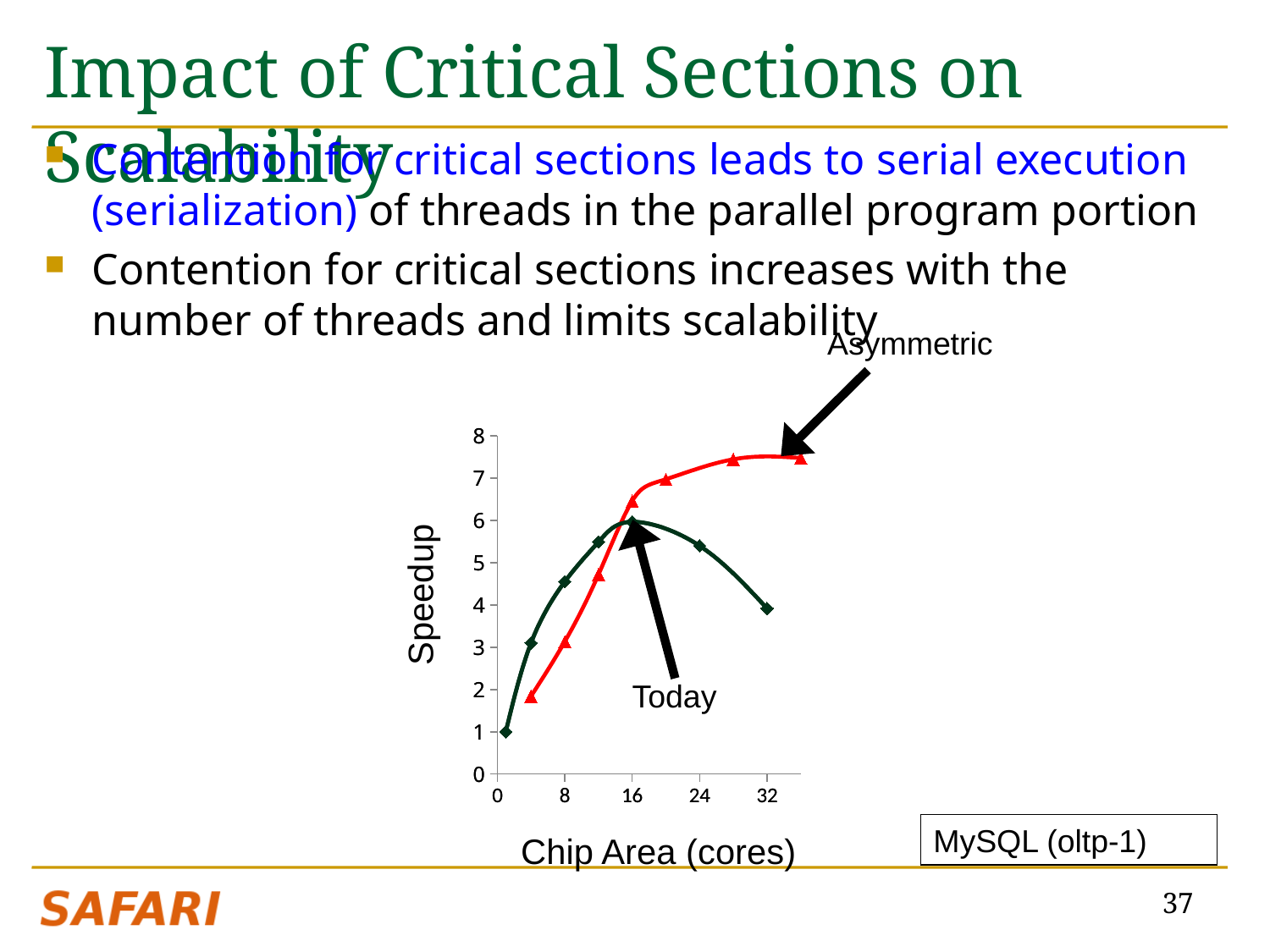
At 24 cores, which curve has the higher speedup, Today (green) or Asymmetric (red)? Asymmetric (red) Is the speedup of the Asymmetric (red) curve at 32 cores greater or less than 7? greater At 8 cores, which curve has the higher speedup, Today (green) or Asymmetric (red)? Today (green) Is the speedup of the Today (green) curve at 8 cores greater or less than 4? greater How does the speedup of the Today (green) curve change as chip area increases beyond 16 cores? it falls What kind of chart is shown on the slide? line chart Is the speedup of the Asymmetric (red) curve at 4 cores greater or less than 2? less What is the label of the x axis of the chart? Chip Area (cores) What is the label of the y axis of the chart? Speedup At 32 cores, which curve has the higher speedup, Today (green) or Asymmetric (red)? Asymmetric (red)